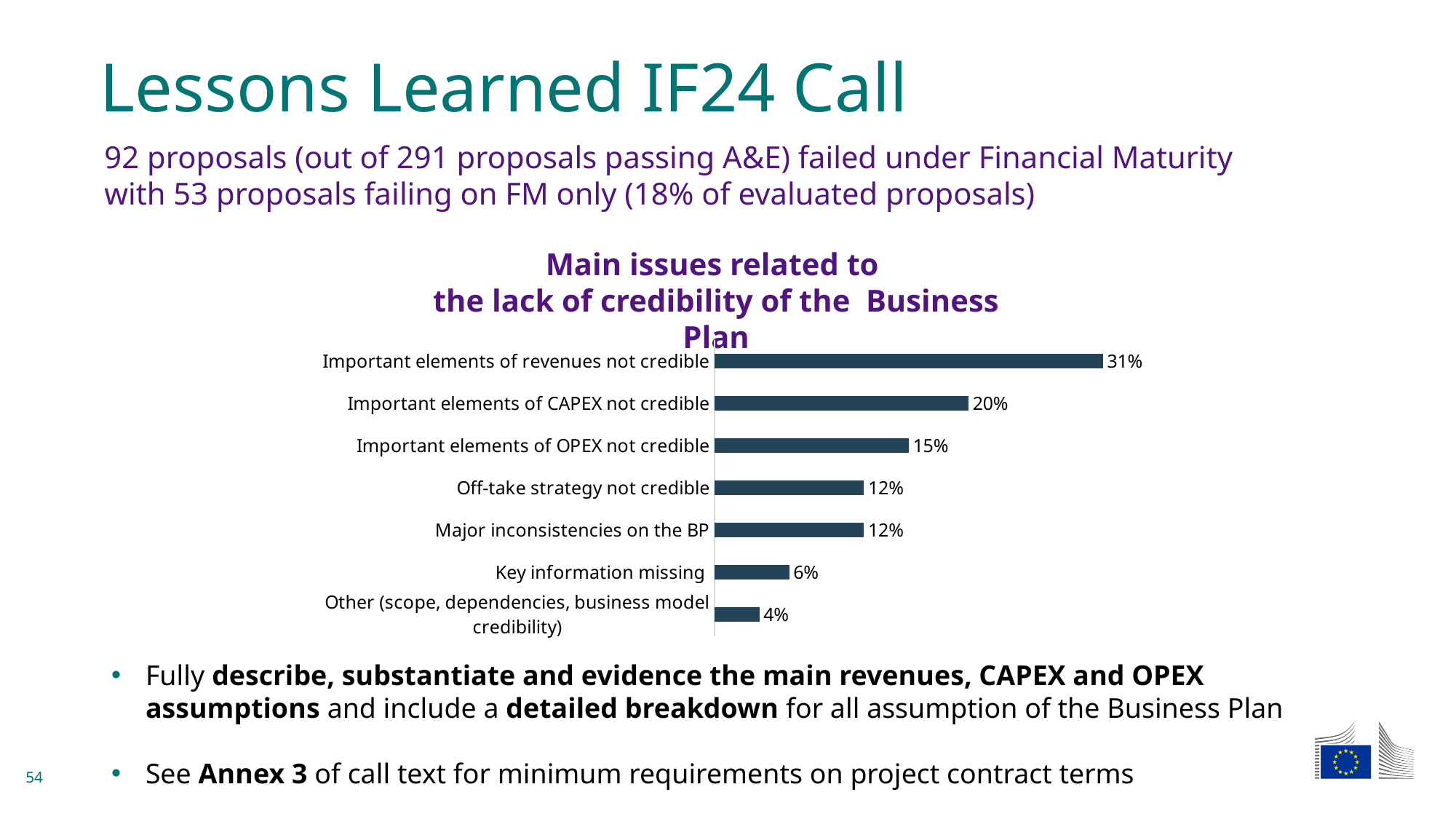
What is the value for 'Important elements of CAPEX not credible'? 20% Which category has the lowest value? Other (scope, dependencies, business model credibility) What is the difference between 'Important elements of OPEX not credible' and 'Key information missing'? 9% What is the value for 'Important elements of revenues not credible'? 31% Which is larger: 'Important elements of OPEX not credible' or 'Off-take strategy not credible'? Important elements of OPEX not credible What kind of chart is shown on the slide? Bar chart Which category has the highest value? Important elements of revenues not credible What is the title of the chart? Main issues related to the lack of credibility of the Business Plan What is the value for 'Key information missing'? 6% How many categories are shown in the chart? 7 What is the value for 'Other (scope, dependencies, business model credibility)'? 4% What is the difference between 'Important elements of revenues not credible' and 'Important elements of CAPEX not credible'? 11%